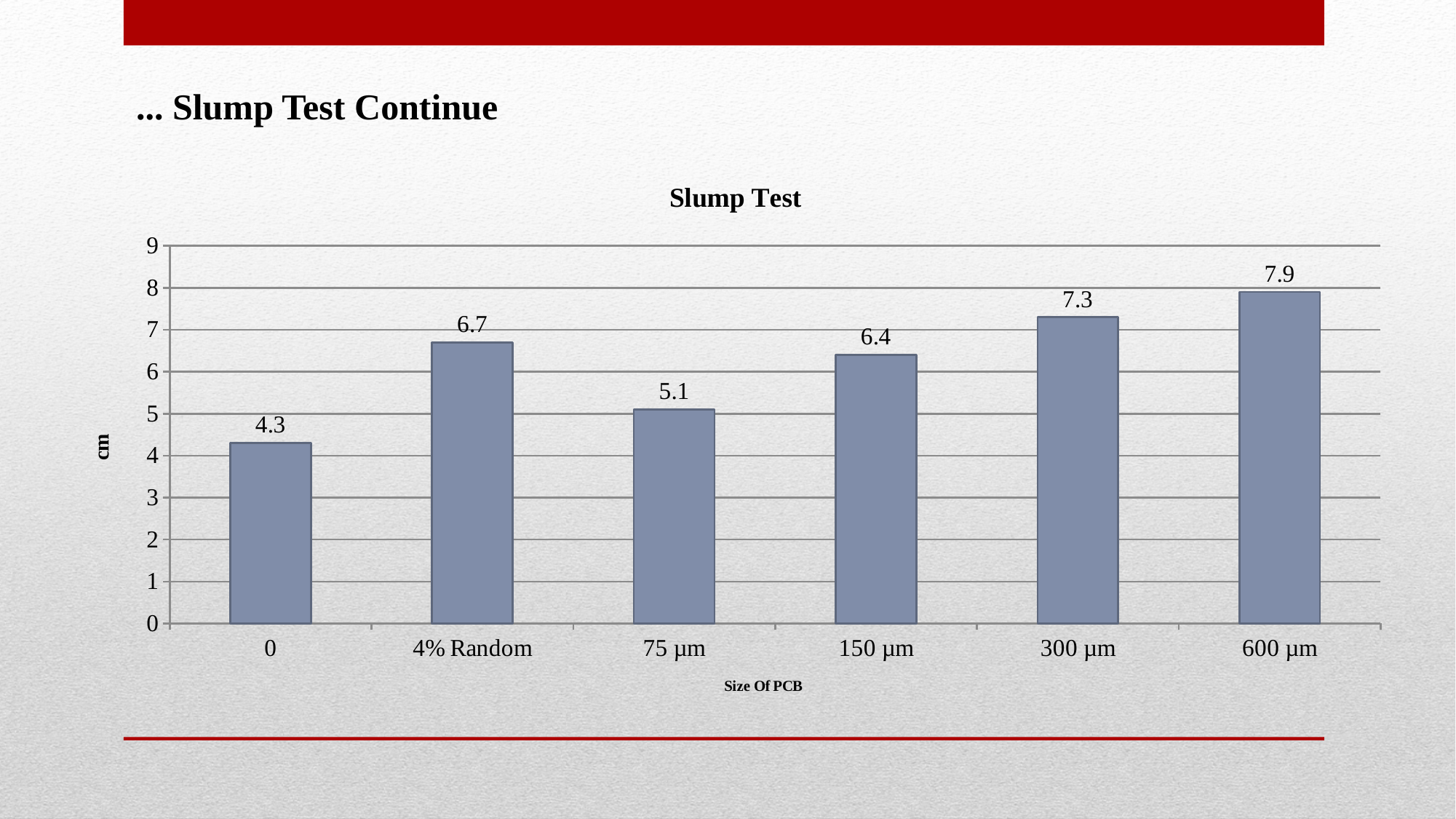
What is the title of the chart? Slump Test What is the slump value for 300 µm? 7.3 Which size of PCB has the lowest slump value? 0 Which has a larger slump value, 150 µm or 4% Random? 4% Random What is the slump value for 4% Random? 6.7 Which size of PCB has the highest slump value? 600 µm What kind of chart is shown on the slide? bar chart How many categories are shown on the x axis? 6 Is the slump value for 75 µm greater or less than 6? less Do the slump values rise or fall from 75 µm to 600 µm? rise What is the slump value for the 0 category? 4.3 What is the difference between the slump values for 600 µm and 75 µm? 2.8